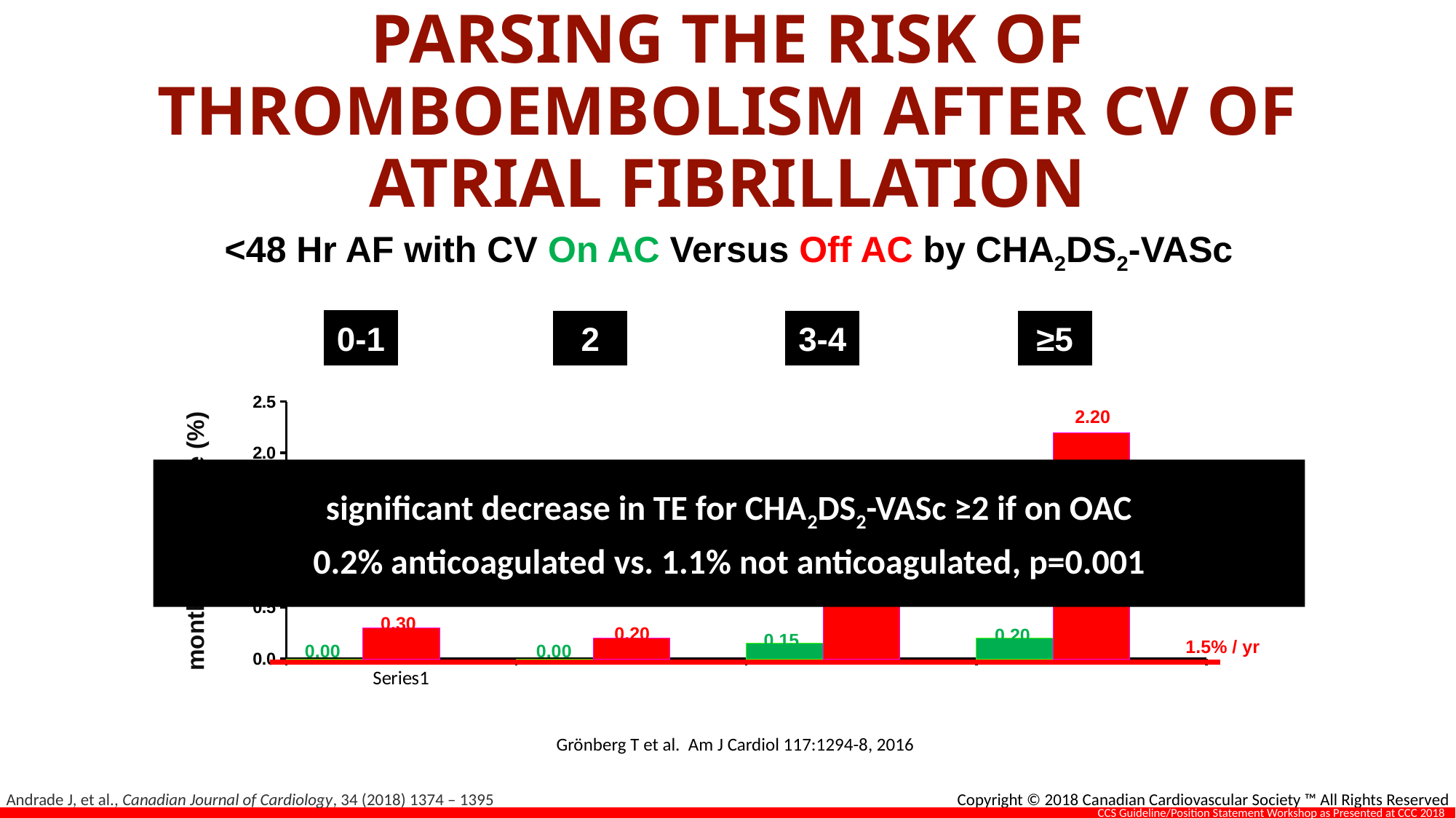
What is the Off AC value for the CHA2DS2-VASc ≥5 group? 2.20 How many CHA2DS2-VASc groups are shown on the chart? 4 What is the On AC value for the CHA2DS2-VASc 3-4 group? 0.15 What kind of chart is shown on the slide? bar chart What is the On AC value for the CHA2DS2-VASc ≥5 group? 0.20 Which is larger: the Off AC value for the ≥5 group or the Off AC value for the 0-1 group? ≥5 What is the On AC value for the CHA2DS2-VASc 0-1 group? 0.00 What is the difference between the Off AC and On AC values for the ≥5 group? 2.00 Is the Off AC value for the 3-4 group greater or less than 0.5? greater Which CHA2DS2-VASc group has the highest Off AC value? ≥5 What is the Off AC value for the CHA2DS2-VASc 2 group? 0.20 What is the Off AC value for the CHA2DS2-VASc 0-1 group? 0.30